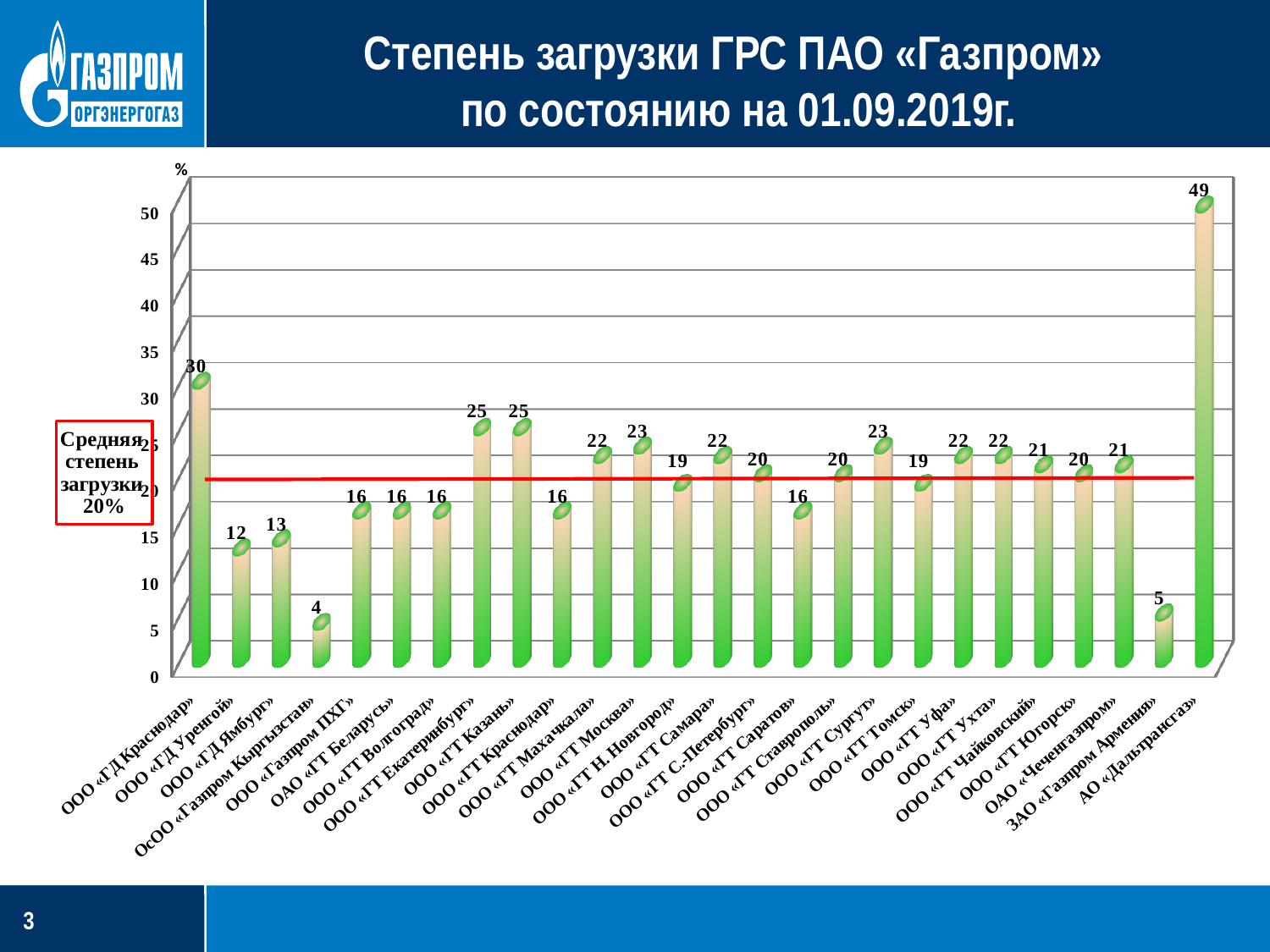
What is the value for ОсОО «Газпром Кыргызстан»? 4 What is the value for ООО «ГТ Казань»? 25 Is the value for ООО «ГД Уренгой» greater or less than 15? less Which is larger, the value for ООО «ГТ Москва» or the value for ООО «ГТ Н. Новгород»? ООО «ГТ Москва» What is the value for ООО «ГД Краснодар»? 30 How many categories are shown on the x axis? 26 What kind of chart is shown on the slide? bar chart What average load level does the red horizontal line mark? 20% What is the value for АО «Дальтрансгаз»? 49 Which category has the lowest value? ОсОО «Газпром Кыргызстан» What is the difference between the values for АО «Дальтрансгаз» and ООО «ГД Краснодар»? 19 Which category has the highest value? АО «Дальтрансгаз»